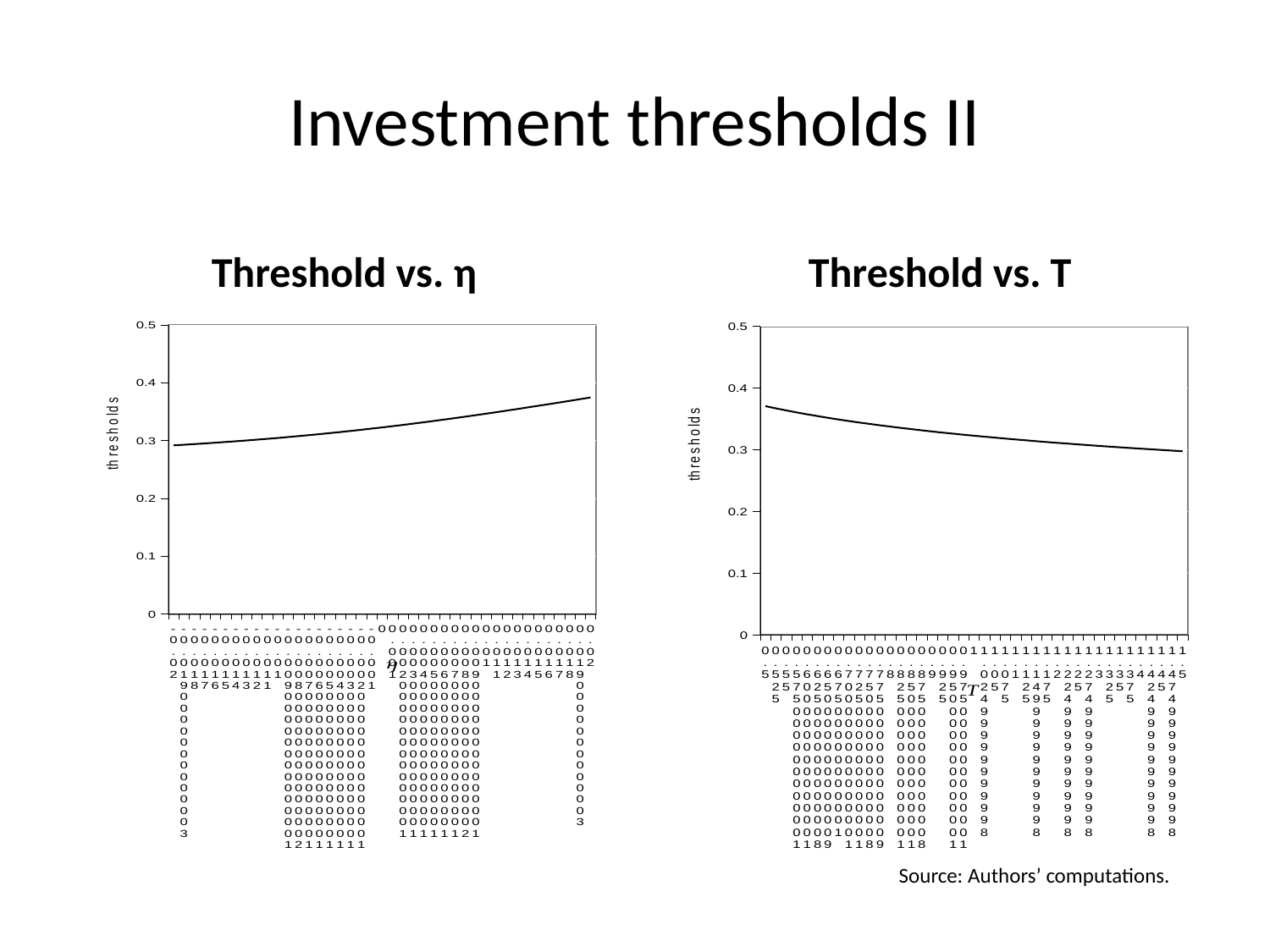
In the "Threshold vs. T" chart, are all plotted threshold values greater or less than 0.2? greater What is the maximum value shown on the y axis of the "Threshold vs. T" chart? 0.5 What kind of chart is the "Threshold vs. η" chart? line chart In the "Threshold vs. η" chart, do the threshold values rise or fall as η increases along the x axis? rise In the "Threshold vs. T" chart, is the threshold value at the left end of the line greater or less than 0.3? greater In the "Threshold vs. T" chart, is the threshold value at the left end of the line greater or less than 0.4? less What is the label on the y axis of the "Threshold vs. η" chart? thresholds How many charts are shown on the slide? 2 In the "Threshold vs. T" chart, do the threshold values rise or fall as T increases along the x axis? fall What kind of chart is the "Threshold vs. T" chart? line chart